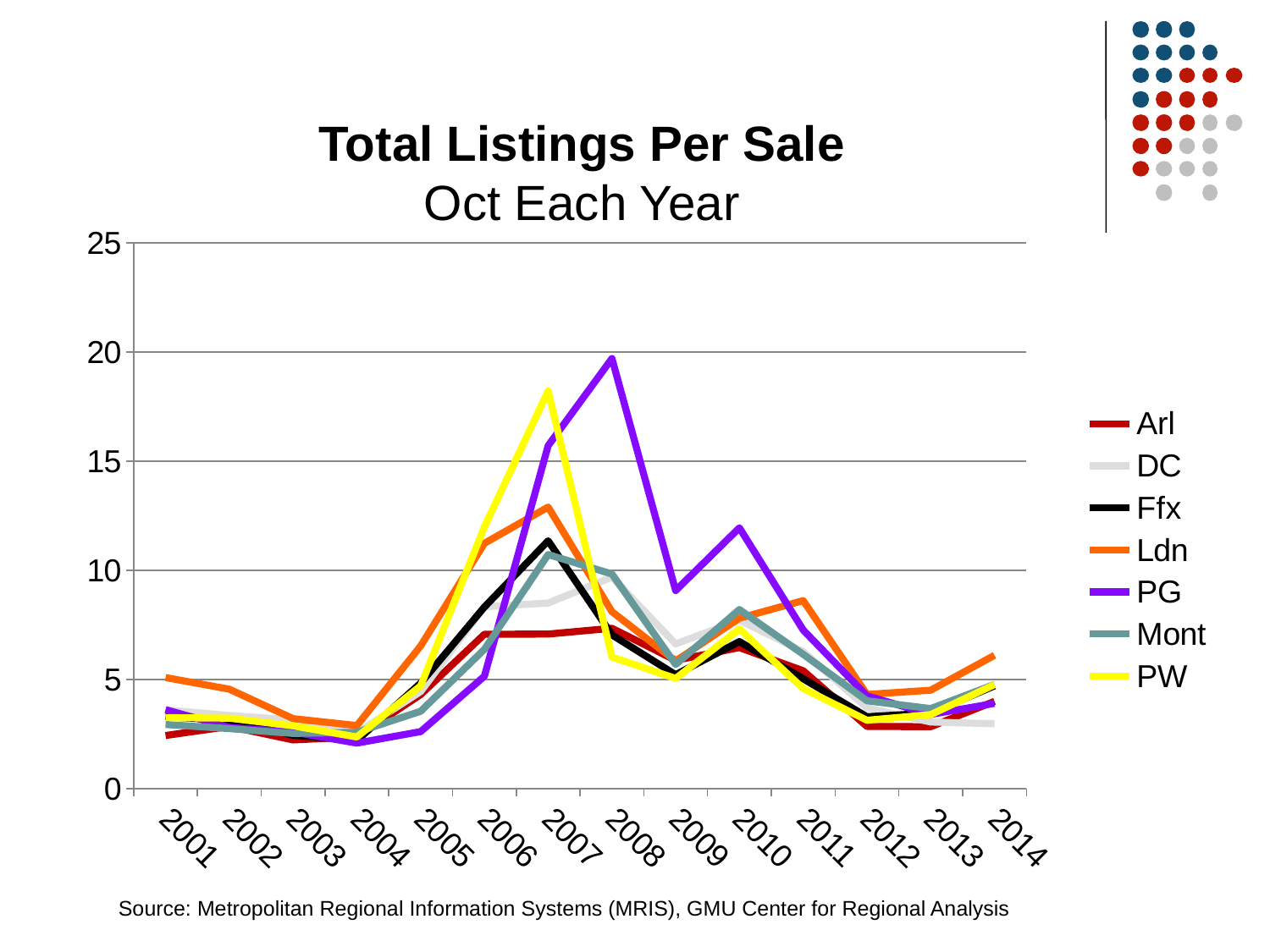
Is the value for PG in 2008 greater or less than 15? greater Is the value for PG in 2010 greater or less than 10? greater What is the title of the chart? Total Listings Per Sale Oct Each Year Does the PG line rise or fall from 2008 to 2009? fall Which is larger in 2008, the value for PG or the value for Arl? PG Is the value for Arl in 2001 greater or less than 5? less How many years are shown along the x axis? 14 What kind of chart is shown on the slide? line chart Does the Ldn line rise or fall from 2004 to 2007? rise Which series reaches the highest value anywhere on the chart? PG How many series does the legend list? 7